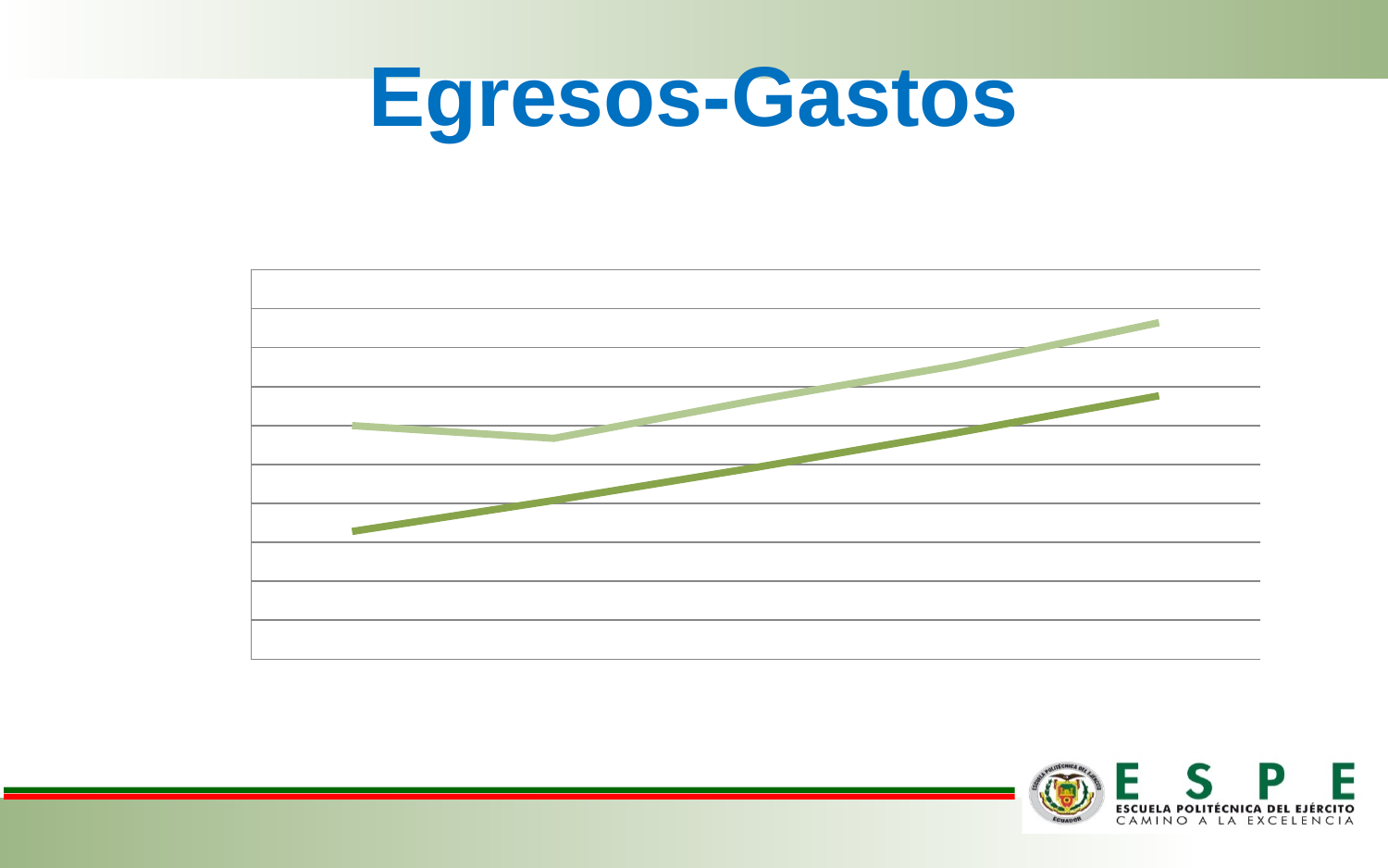
Does the darker green line rise or fall from left to right? rise How many lines are plotted on the chart? 2 What kind of chart is shown on the slide? line chart Does the chart display a legend? No Overall, does the lighter green line end higher or lower than where it starts? higher What is the title of the slide containing the chart? Egresos-Gastos Which line is higher at the left end of the chart, the lighter green line or the darker green line? the lighter green line Does the lighter green line dip or rise between its first and second points? dip Which line is higher at the right end of the chart, the lighter green line or the darker green line? the lighter green line